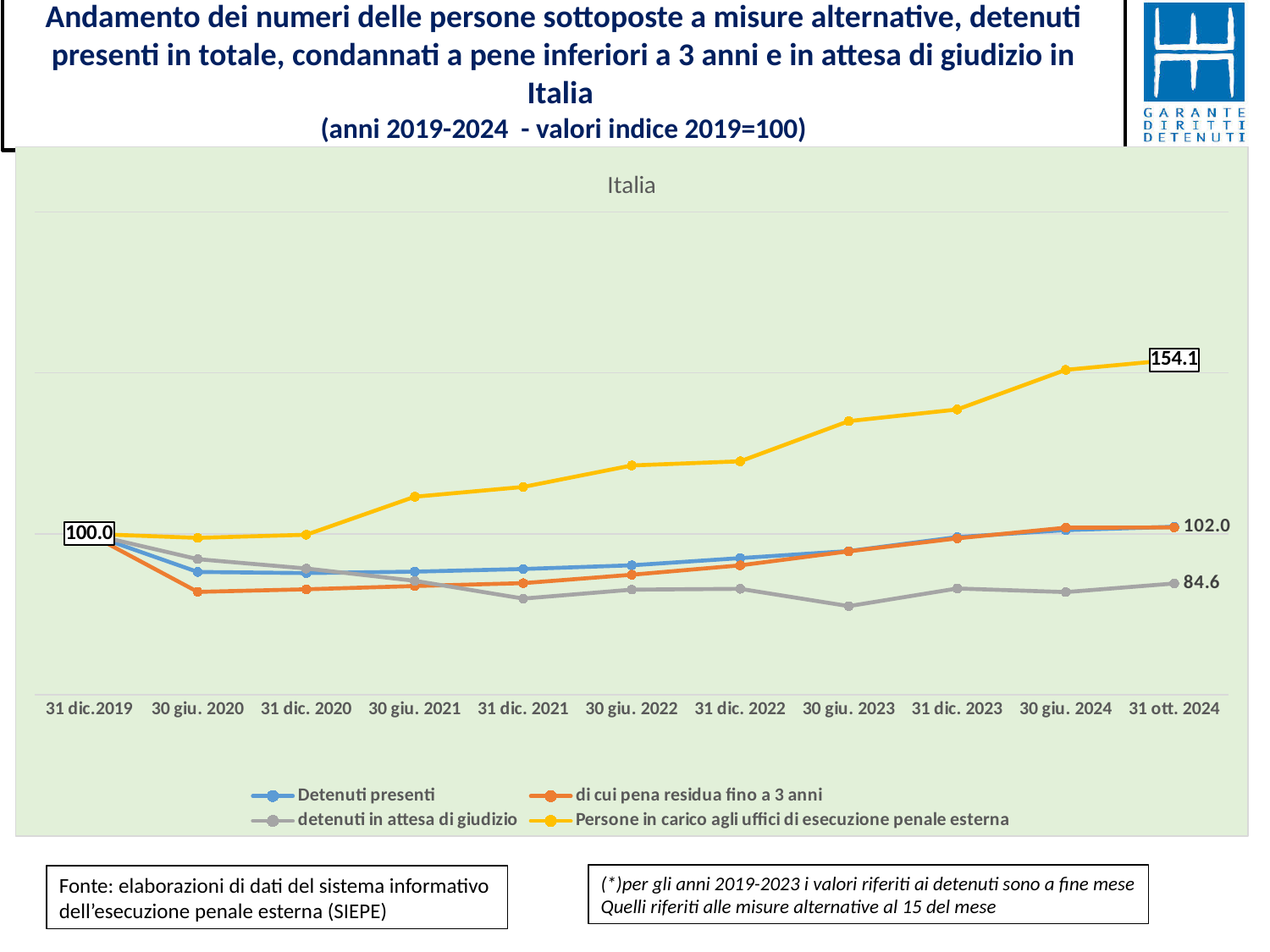
What is the value for 'Persone in carico agli uffici di esecuzione penale esterna' at 31 ott. 2024? 154.1 Does the series 'Persone in carico agli uffici di esecuzione penale esterna' rise or fall from 31 dic.2019 to 31 ott. 2024? rise How many series does the legend list? 4 Which series has the highest value at 31 ott. 2024? Persone in carico agli uffici di esecuzione penale esterna What kind of chart is shown on the slide? line chart What is the index value shown for all series at 31 dic.2019? 100.0 Which series has the lowest value at 31 ott. 2024? detenuti in attesa di giudizio How many dates are shown along the x axis? 11 What is the difference between the value for 'Persone in carico agli uffici di esecuzione penale esterna' and the value for 'detenuti in attesa di giudizio' at 31 ott. 2024? 69.5 What is the title shown above the plot area of the chart? Italia At 31 ott. 2024, which is larger: 'Persone in carico agli uffici di esecuzione penale esterna' or 'detenuti in attesa di giudizio'? Persone in carico agli uffici di esecuzione penale esterna What is the value for 'detenuti in attesa di giudizio' at 31 ott. 2024? 84.6